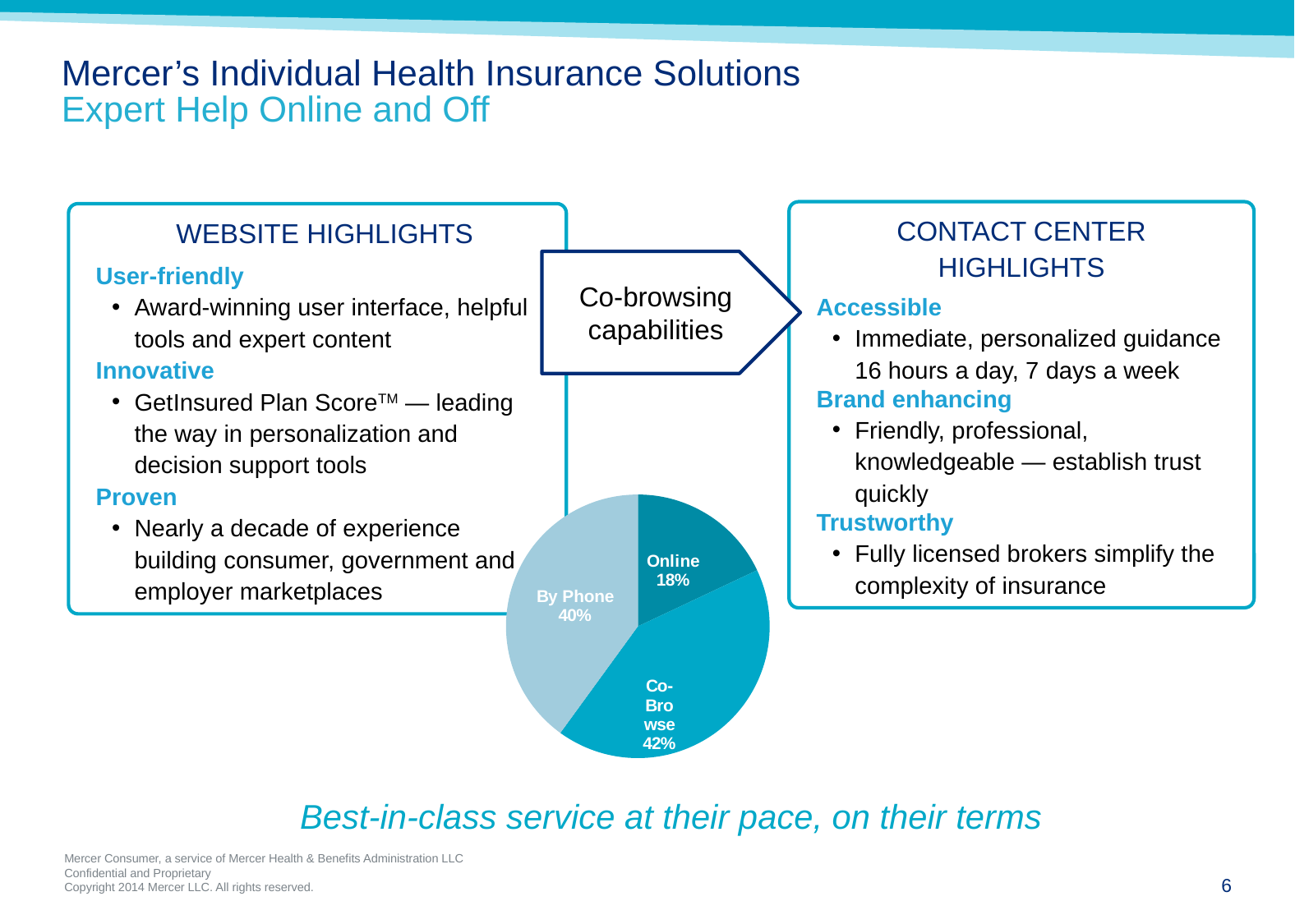
What is the combined share of the By Phone and Online slices? 58% What share does the By Phone slice represent? 40% Which slice of the pie is the smallest? Online How many slices does the pie chart have? 3 Which slice of the pie is the largest? Co-Browse What is the difference in percentage points between the Co-Browse and Online slices? 24 What kind of chart is shown on the slide? pie chart Which is larger, the By Phone slice or the Online slice? By Phone Which slice of the pie is shown in the lightest blue colour? By Phone What share does the Co-Browse slice represent? 42% What is the difference in percentage points between the By Phone and Online slices? 22 What share does the Online slice represent? 18%